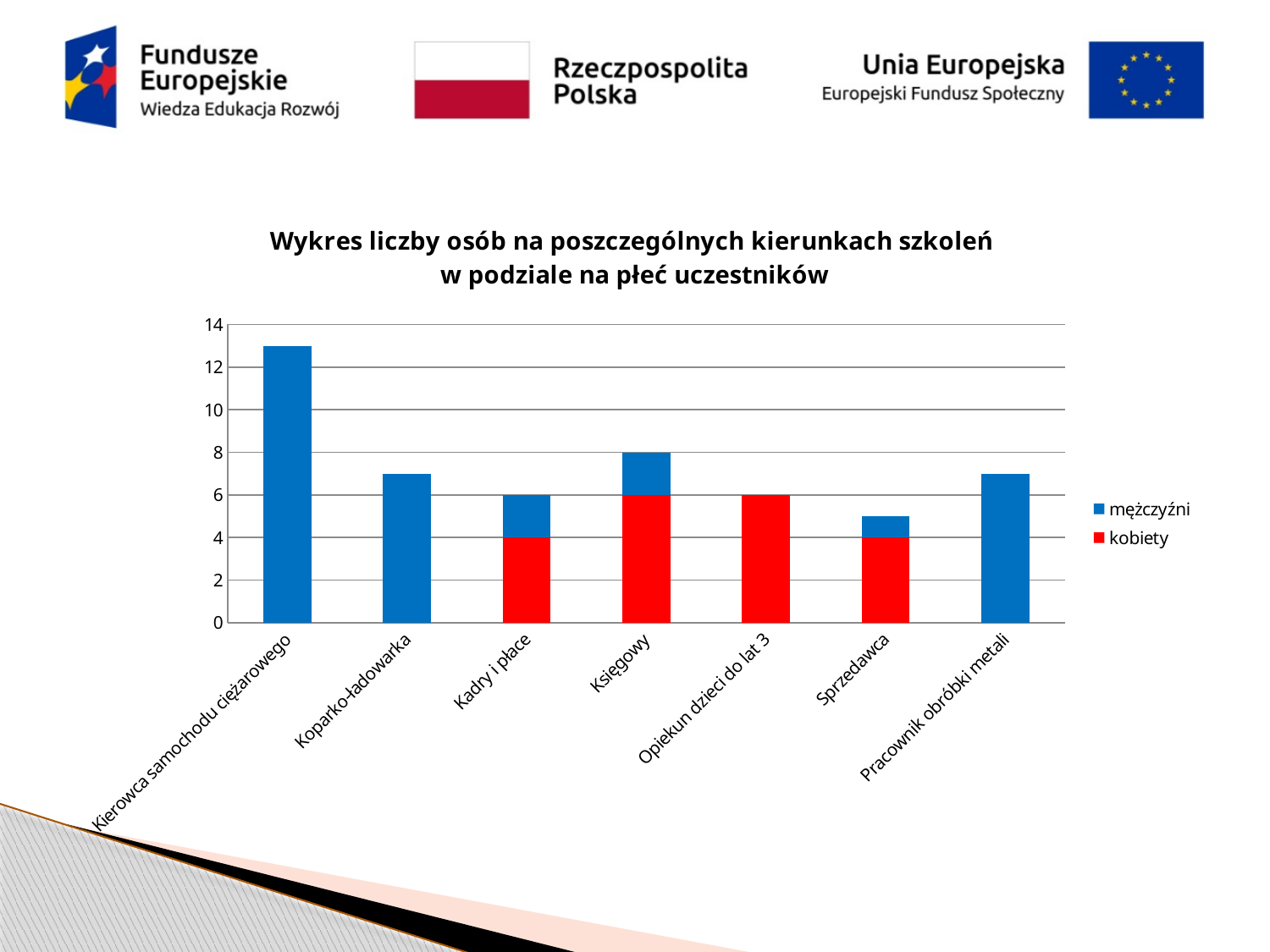
Which is larger: the bar for Kierowca samochodu ciężarowego or the bar for Księgowy? Kierowca samochodu ciężarowego What is the difference between the total for Księgowy and the total for Kadry i płace? 2 Which two series are listed in the chart legend? mężczyźni and kobiety How many series does the chart legend list? 2 What is the value for kobiety in the Kadry i płace category? 4 Is the value for Kierowca samochodu ciężarowego greater or less than 12? greater Which training category has the shortest bar in the chart? Sprzedawca How many training categories are shown on the x axis of the chart? 7 What is the total height of the stacked bar for Księgowy? 8 Which training category has the tallest bar in the chart? Kierowca samochodu ciężarowego What is the value for kobiety in the Księgowy category? 6 What type of chart is shown on the slide? bar chart